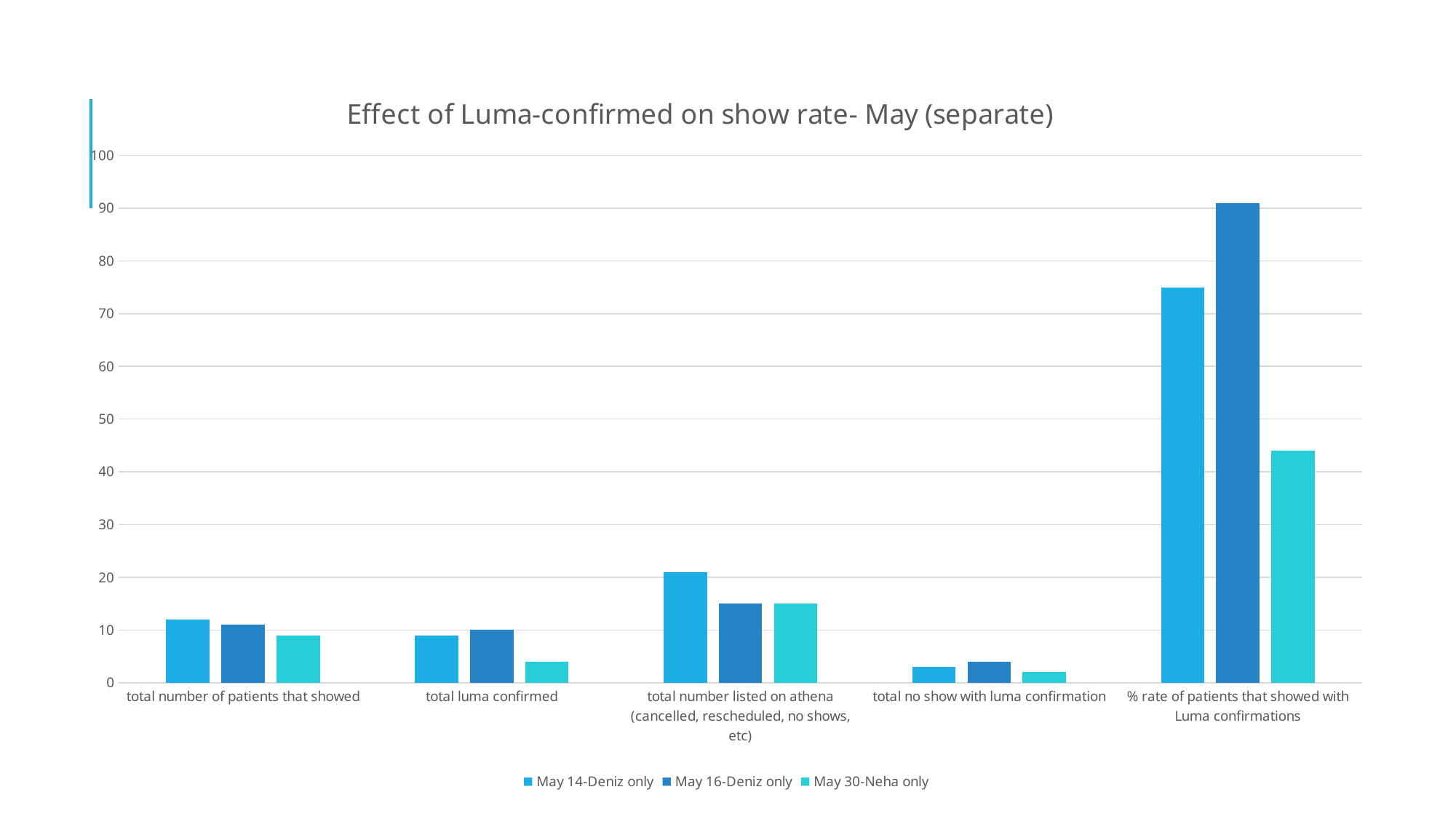
For 'total luma confirmed', which is larger: the May 16-Deniz only value or the May 30-Neha only value? May 16-Deniz only Which series has the highest value for 'total number listed on athena (cancelled, rescheduled, no shows, etc)'? May 14-Deniz only Which series has the highest value for '% rate of patients that showed with Luma confirmations'? May 16-Deniz only Which series is shown in the lightest teal colour in the legend? May 30-Neha only What kind of chart is shown on the slide? bar chart How many categories are shown on the x axis? 5 Which series has the lowest value for '% rate of patients that showed with Luma confirmations'? May 30-Neha only What is the title of the chart? Effect of Luma-confirmed on show rate- May (separate) Is the May 30-Neha only value for '% rate of patients that showed with Luma confirmations' greater or less than 50? less How many series does the legend list? 3